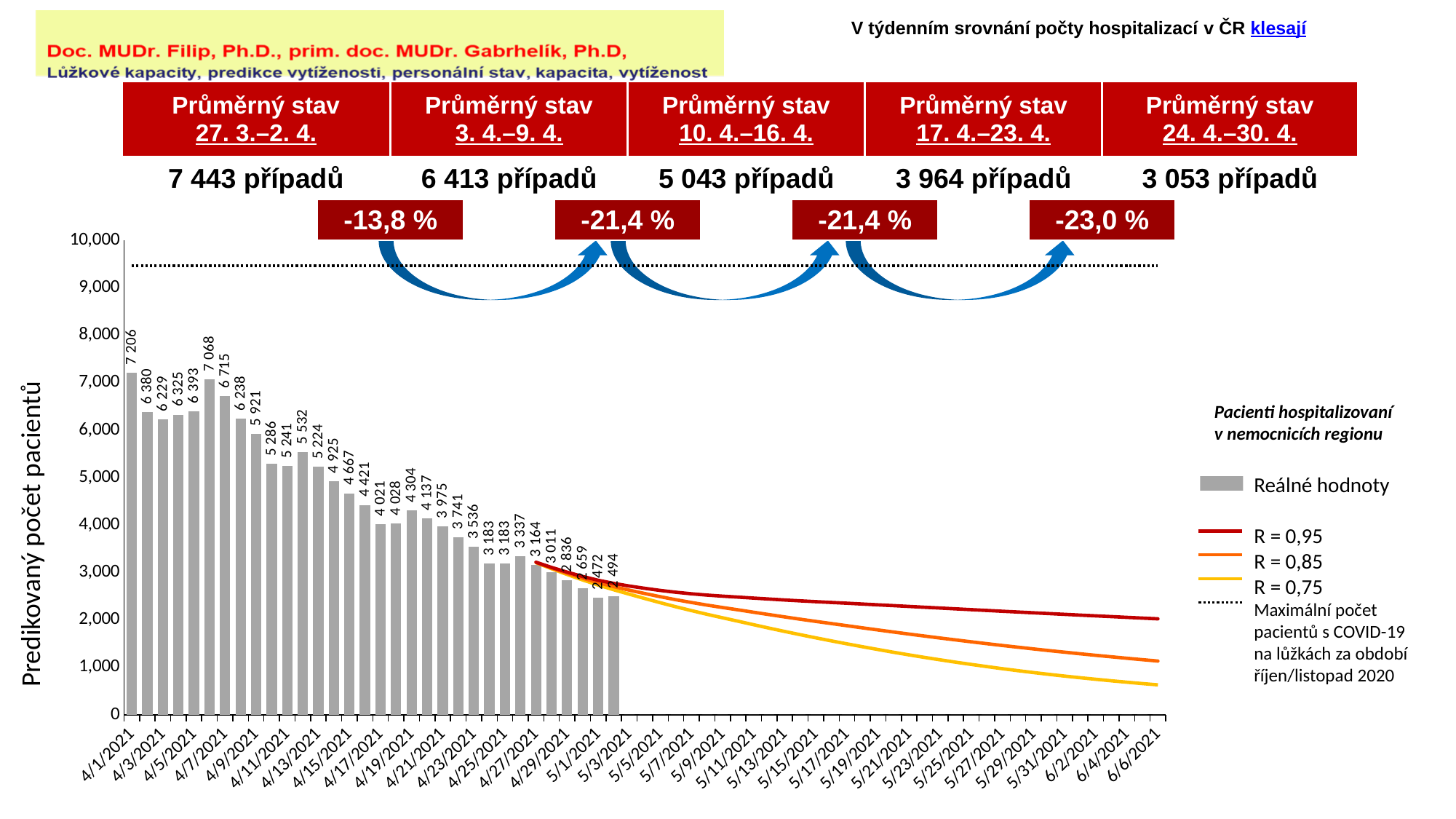
What is the average number of cases shown for the period 27. 3.–2. 4.? 7 443 případů Do the grey bars generally rise or fall from left to right along the x axis? fall What percentage change is shown between the periods 3. 4.–9. 4. and 10. 4.–16. 4.? -21,4 % What is the difference between the average for 27. 3.–2. 4. (7 443) and the average for 3. 4.–9. 4. (6 413)? 1 030 What is the difference between the highest bar (7 206) and the lowest bar (2 472)? 4 734 How many entries does the legend list? 5 What kind of chart is shown on the slide? bar chart (with projection lines) What is the value of the highest bar in the chart? 7 206 At the right end of the chart (6/6/2021), which projection line is higher: R = 0,95 or R = 0,75? R = 0,95 Is the dotted horizontal line (Maximální počet pacientů s COVID-19) greater or less than 9,000? greater What is the value of the first bar, for 4/1/2021? 7 206 What is the value of the lowest bar in the chart? 2 472